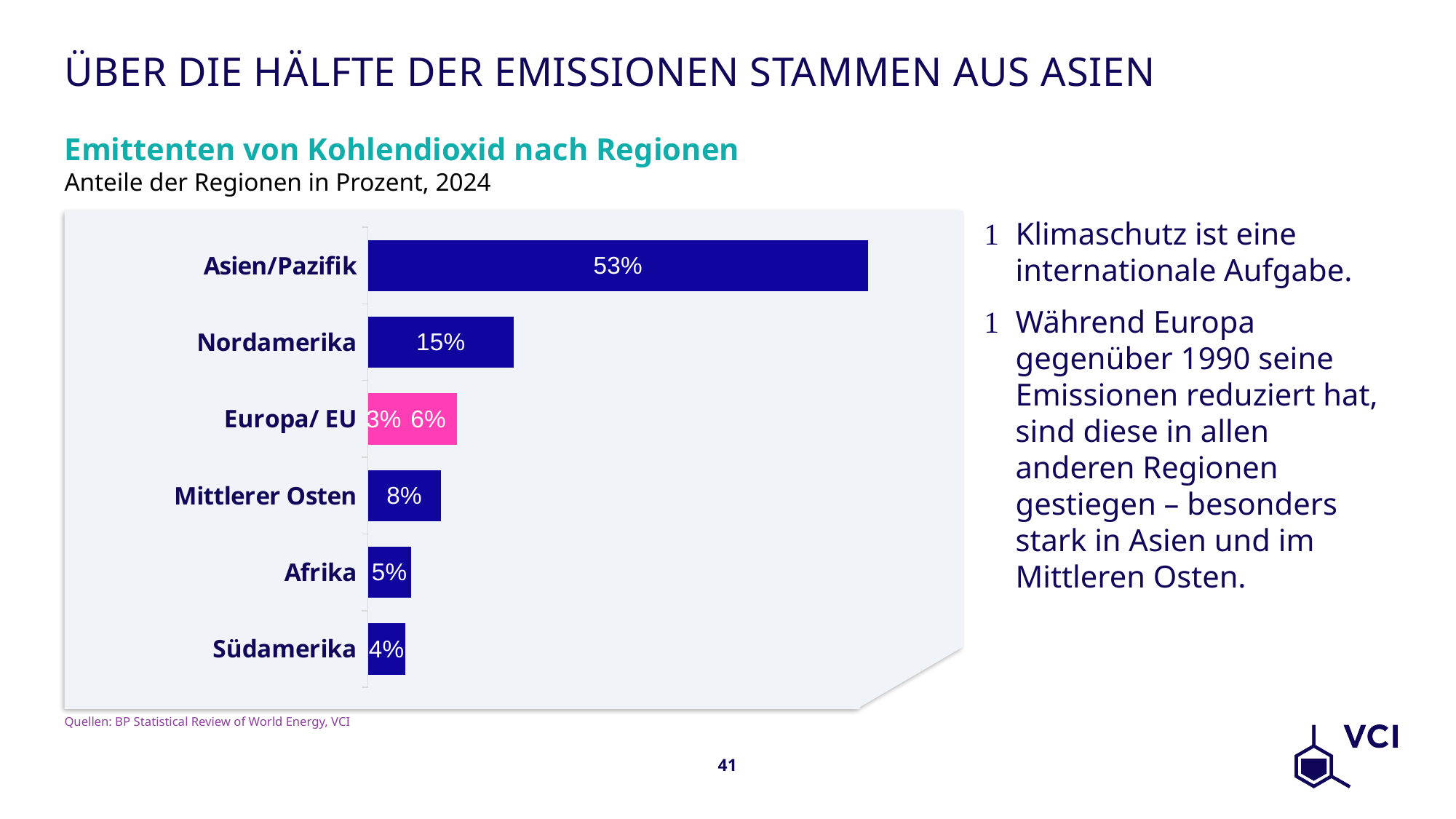
Which region has the smallest share of emissions in the chart? Südamerika What share of carbon dioxide emissions does the chart attribute to Asien/Pazifik? 53% What type of chart is shown on the slide? Bar chart What is the value shown for Südamerika? 4% Which region has the largest share of emissions in the chart? Asien/Pazifik How many percentage points higher is the share for Asien/Pazifik than for Nordamerika? 38 percentage points Which has the larger share, Mittlerer Osten or Afrika? Mittlerer Osten What is the value shown for Nordamerika? 15% Which region's bar is coloured pink instead of dark blue? Europa/ EU What is the value shown for Mittlerer Osten? 8% How many regions are shown in the chart? 6 What is the value shown for Afrika? 5%